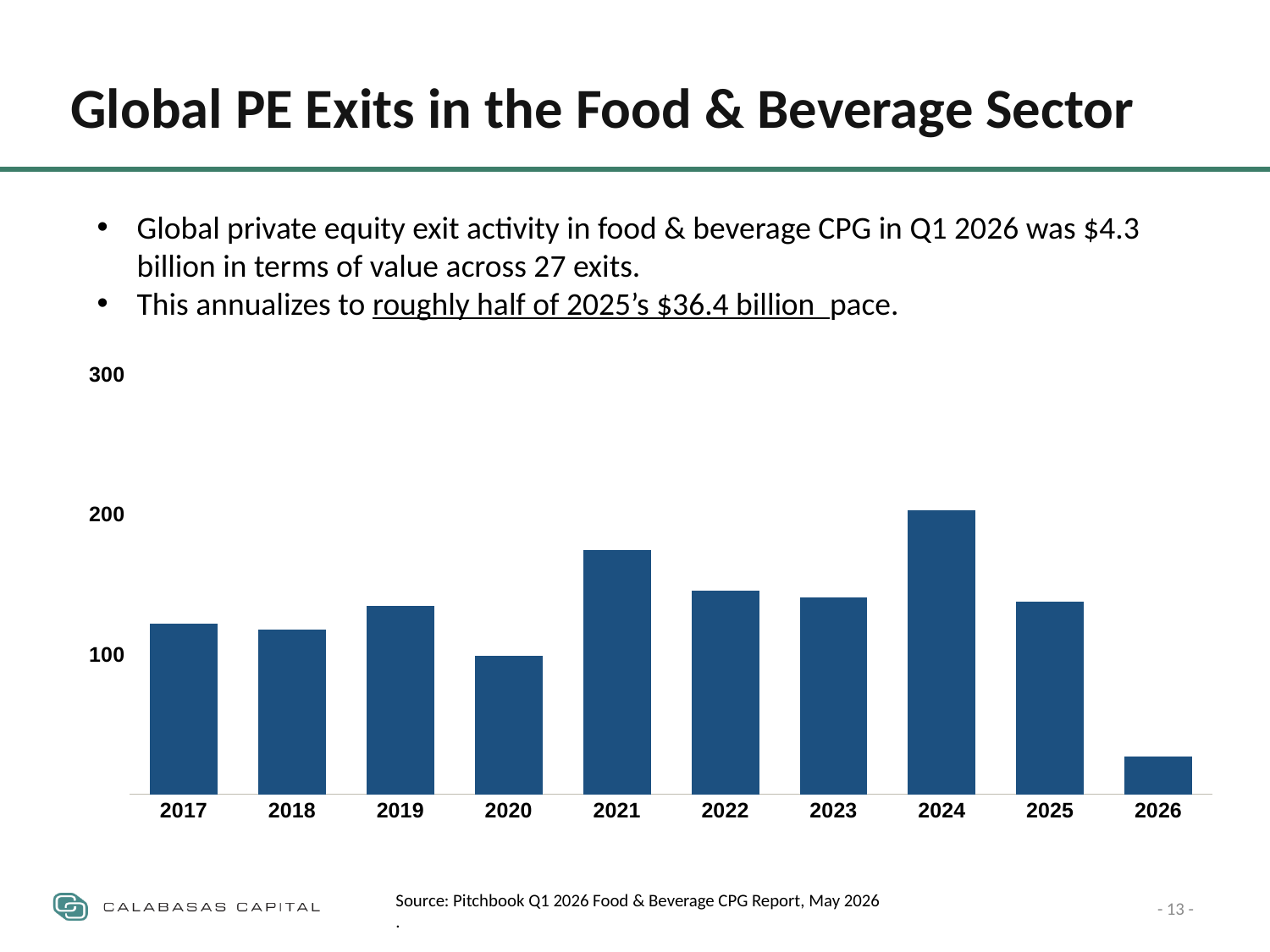
Which year has the lowest bar in the chart? 2026 What is the title of the slide containing the chart? Global PE Exits in the Food & Beverage Sector Is the value for 2021 greater or less than 100? greater Is the value for 2017 greater or less than 100? greater How many years are shown on the x axis of the chart? 10 Which year has the larger bar, 2021 or 2022? 2021 Is the value for 2026 greater or less than 100? less What kind of chart is shown on the slide? bar chart Which year has the highest bar in the chart? 2024 Do the bars rise or fall from 2024 to 2026? fall Which year has the larger bar, 2024 or 2025? 2024